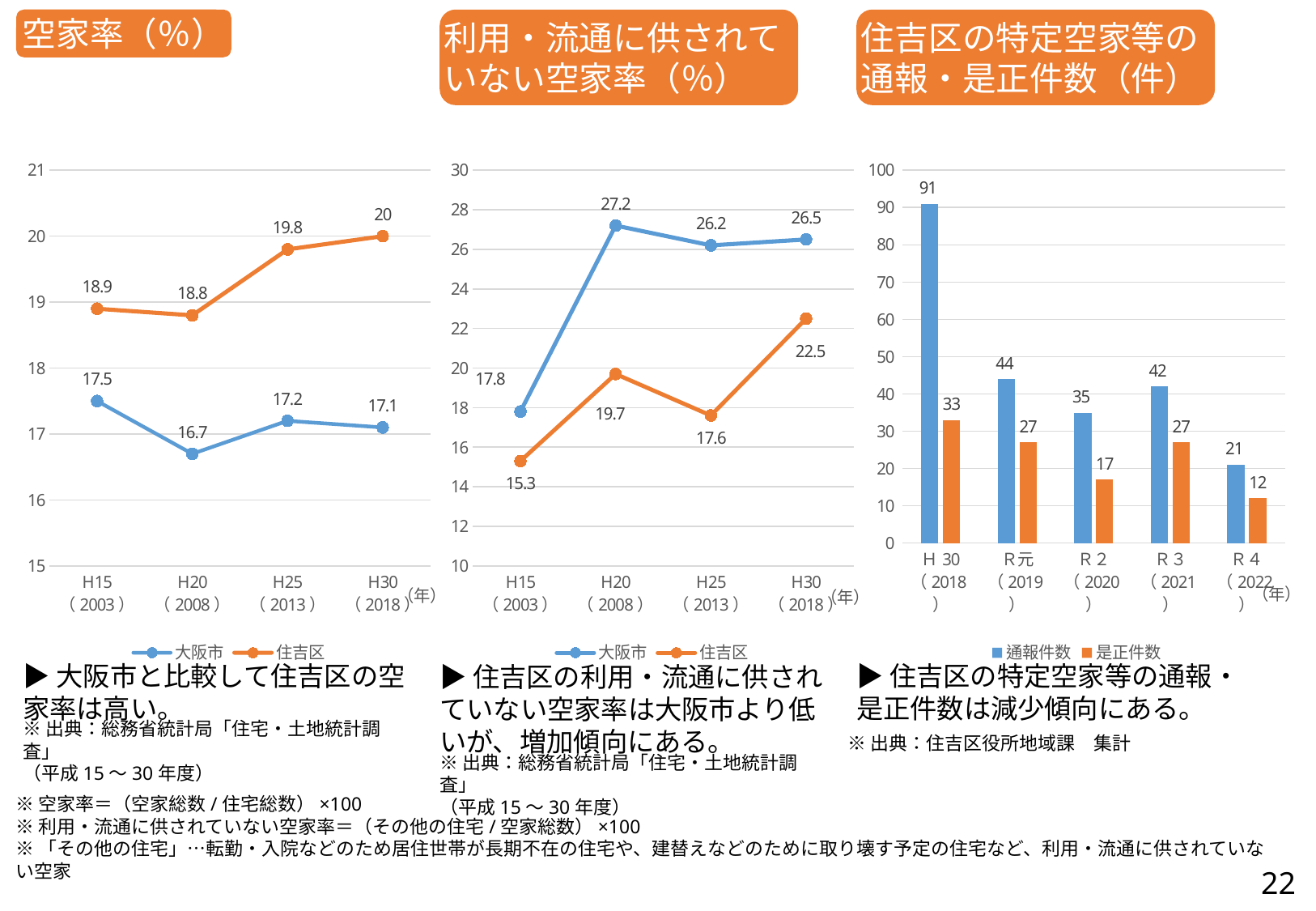
In the right chart titled 住吉区の特定空家等の通報・是正件数（件）, in which year is 是正件数 lowest? R4（2022） In the middle chart titled 利用・流通に供されていない空家率（%）, what is the difference between 大阪市 and 住吉区 in H30（2018）? 4 In the right chart titled 住吉区の特定空家等の通報・是正件数（件）, what is the 通報件数 value for H30（2018）? 91 In the left chart titled 空家率（%）, what is the value for 大阪市 in H20（2008）? 16.7 In the middle chart titled 利用・流通に供されていない空家率（%）, how many series does the legend list? 2 What kind of chart is the right chart titled 住吉区の特定空家等の通報・是正件数（件）? Bar chart In the left chart titled 空家率（%）, which series has the higher value in H25（2013）, 大阪市 or 住吉区? 住吉区 In the left chart titled 空家率（%）, what is the difference between 住吉区 and 大阪市 in H15（2003）? 1.4 In the middle chart titled 利用・流通に供されていない空家率（%）, what is the value for 大阪市 in H20（2008）? 27.2 In the left chart titled 空家率（%）, what is the value for 住吉区 in H30（2018）? 20 In the middle chart titled 利用・流通に供されていない空家率（%）, in which year is the 住吉区 value lowest? H15（2003） In the right chart titled 住吉区の特定空家等の通報・是正件数（件）, what is the difference between 通報件数 and 是正件数 in R2（2020）? 18